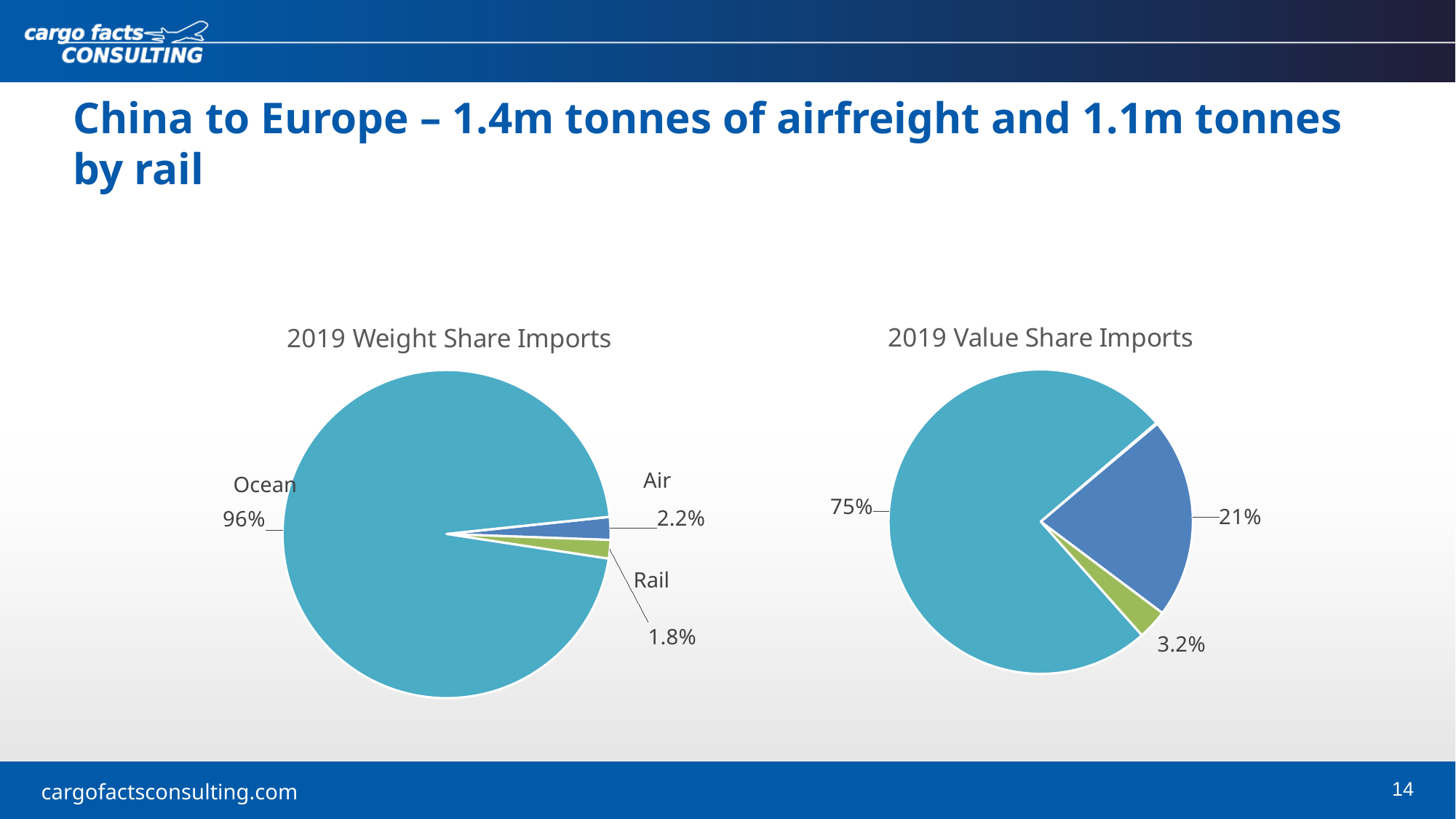
In the 2019 Value Share Imports chart, what is the share of the largest slice? 75% In the 2019 Weight Share Imports chart, which category has the smallest share? Rail In the 2019 Value Share Imports chart, what share does the dark blue slice have? 21% In the 2019 Weight Share Imports chart, what is the difference between the Air and Rail shares? 0.4% In the 2019 Weight Share Imports chart, what share does Ocean have? 96% In the 2019 Weight Share Imports chart, what share does Air have? 2.2% In the 2019 Weight Share Imports chart, which category has the largest share? Ocean In the 2019 Weight Share Imports chart, which is larger, Air or Rail? Air In the 2019 Weight Share Imports chart, what share does Rail have? 1.8% What kind of chart is the 2019 Weight Share Imports chart? pie chart In the 2019 Value Share Imports chart, what is the share of the smallest slice? 3.2% How many slices does the 2019 Weight Share Imports pie chart have? 3